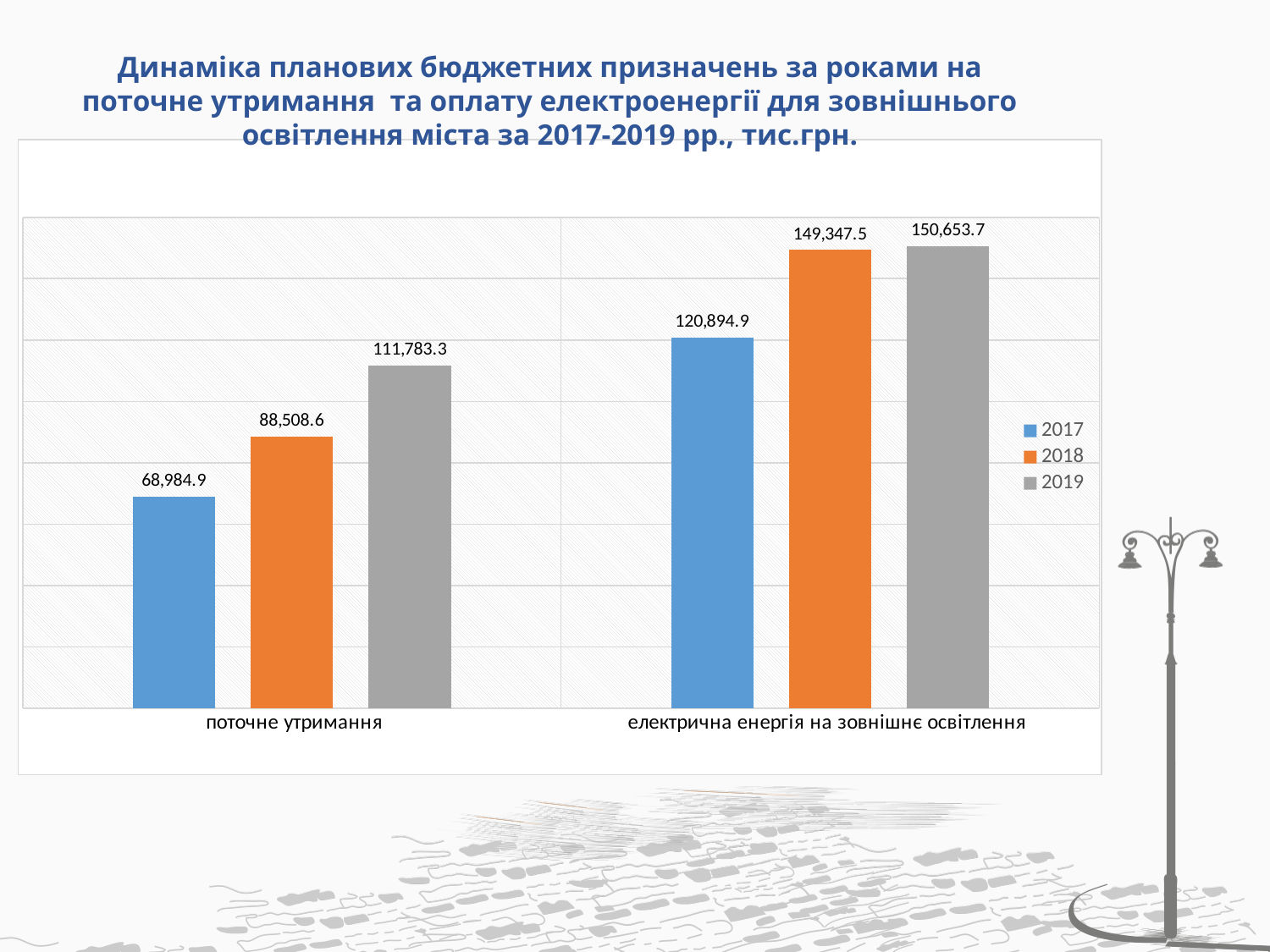
What is the value for 2017 in the "електрична енергія на зовнішнє освітлення" category? 120,894.9 What kind of chart is shown on the slide? Bar chart How many categories are shown on the x axis? 2 What is the value for 2018 in the "поточне утримання" category? 88,508.6 How many series does the legend list? 3 What is the value for 2017 in the "поточне утримання" category? 68,984.9 Which year has the lowest value in the "електрична енергія на зовнішнє освітлення" category? 2017 Which year has the highest value in the "поточне утримання" category? 2019 What is the value for 2019 in the "електрична енергія на зовнішнє освітлення" category? 150,653.7 Which is larger: the 2018 value for "поточне утримання" or the 2017 value for "електрична енергія на зовнішнє освітлення"? 2017 value for електрична енергія на зовнішнє освітлення What is the difference between the 2019 and 2018 values in the "електрична енергія на зовнішнє освітлення" category? 1,306.2 What is the difference between the 2019 and 2017 values in the "поточне утримання" category? 42,798.4